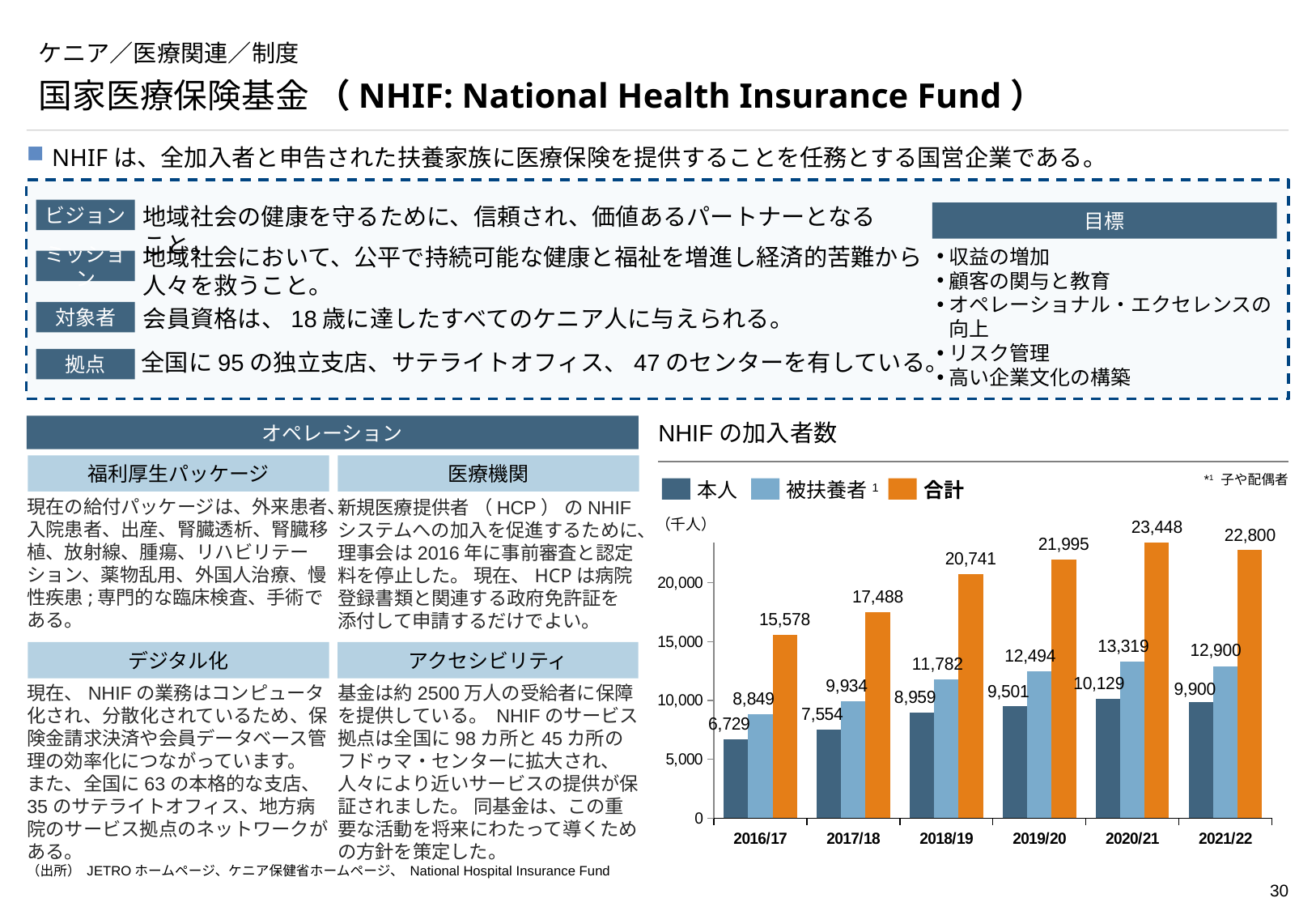
「NHIFの加入者数」のグラフの凡例には、いくつの系列がありますか？ 3 「NHIFの加入者数」のグラフで、2019/20の被扶養者の値はいくつですか？ 12,494 「NHIFの加入者数」のグラフで、2016/17から2020/21にかけて合計は増加していますか、減少していますか？ 増加 「NHIFの加入者数」のグラフで、2021/22の合計と2016/17の合計の差はいくつですか？ 7,222 「NHIFの加入者数」のグラフで、2018/19の合計は20,000より多いですか、少ないですか？ 多い 「NHIFの加入者数」のグラフで、2020/21の合計の値はいくつですか？ 23,448 「NHIFの加入者数」のグラフで、合計が最も多い年度はどれですか？ 2020/21 「NHIFの加入者数」のグラフで、本人の値が最も少ない年度はどれですか？ 2016/17 「NHIFの加入者数」のグラフで、2016/17の本人の値はいくつですか？ 6,729 「NHIFの加入者数」のグラフで、2020/21の本人と2021/22の本人では、どちらが多いですか？ 2020/21 「NHIFの加入者数」のグラフは、どの種類のグラフですか？ 棒グラフ 「NHIFの加入者数」のグラフには、いくつの年度が表示されていますか？ 6